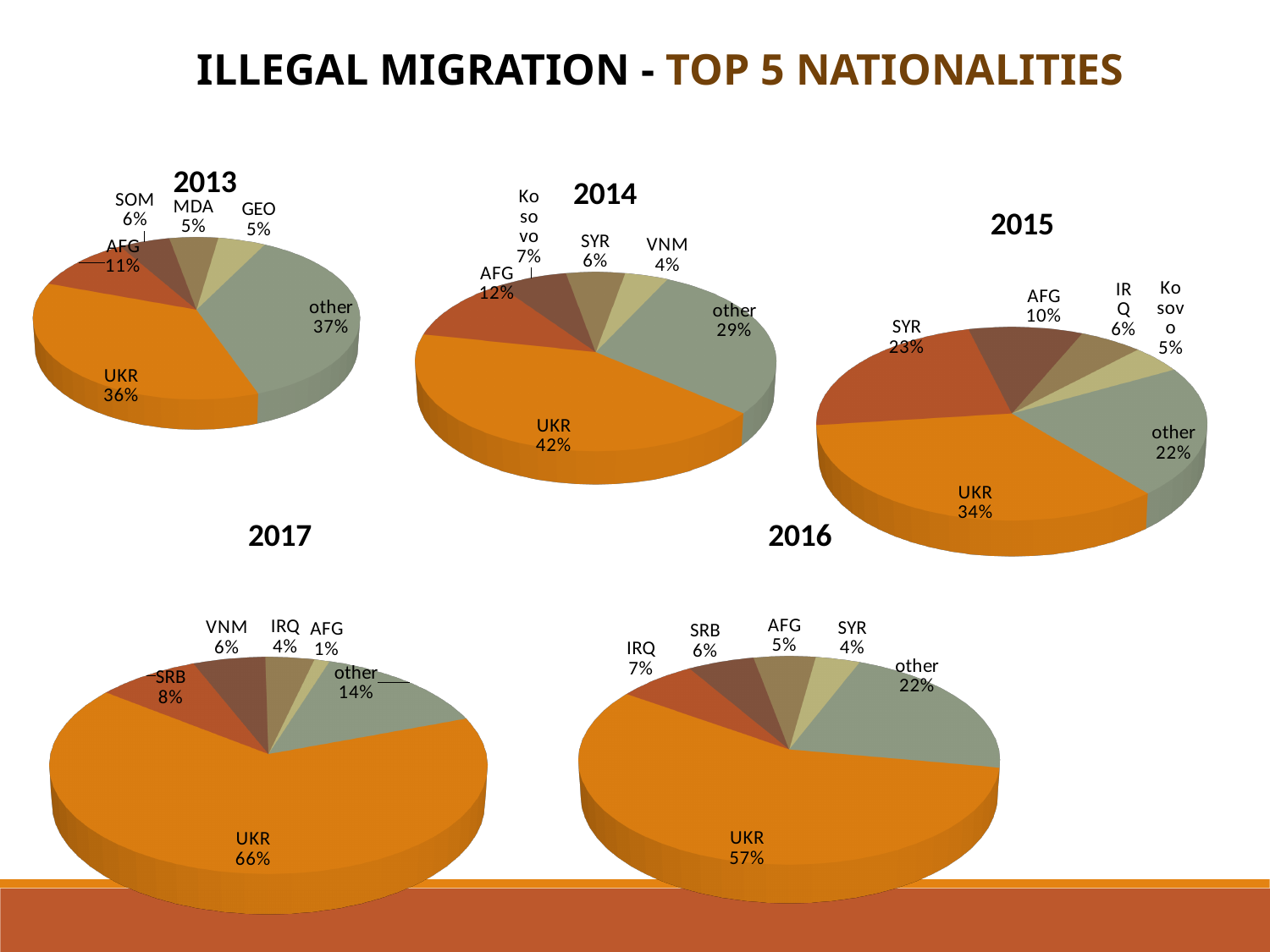
In the 2013 pie chart, which category has the largest share? other In the 2013 pie chart, what share is labelled for UKR? 36% In the 2014 pie chart, what share is labelled for AFG? 12% How many slices does the 2016 pie chart have? 6 In the 2017 pie chart, what share is labelled for AFG? 1% In the 2014 pie chart, which is larger, the share for Kosovo or the share for SYR? Kosovo In the 2017 pie chart, which category has the smallest share? AFG What type of chart is used for each year on this slide? Pie chart In the 2016 pie chart, what share is labelled for UKR? 57% In the 2015 pie chart, what share is labelled for SYR? 23% In the 2015 pie chart, what is the difference between the UKR share and the other share? 12% How many pie charts are shown on the slide? 5